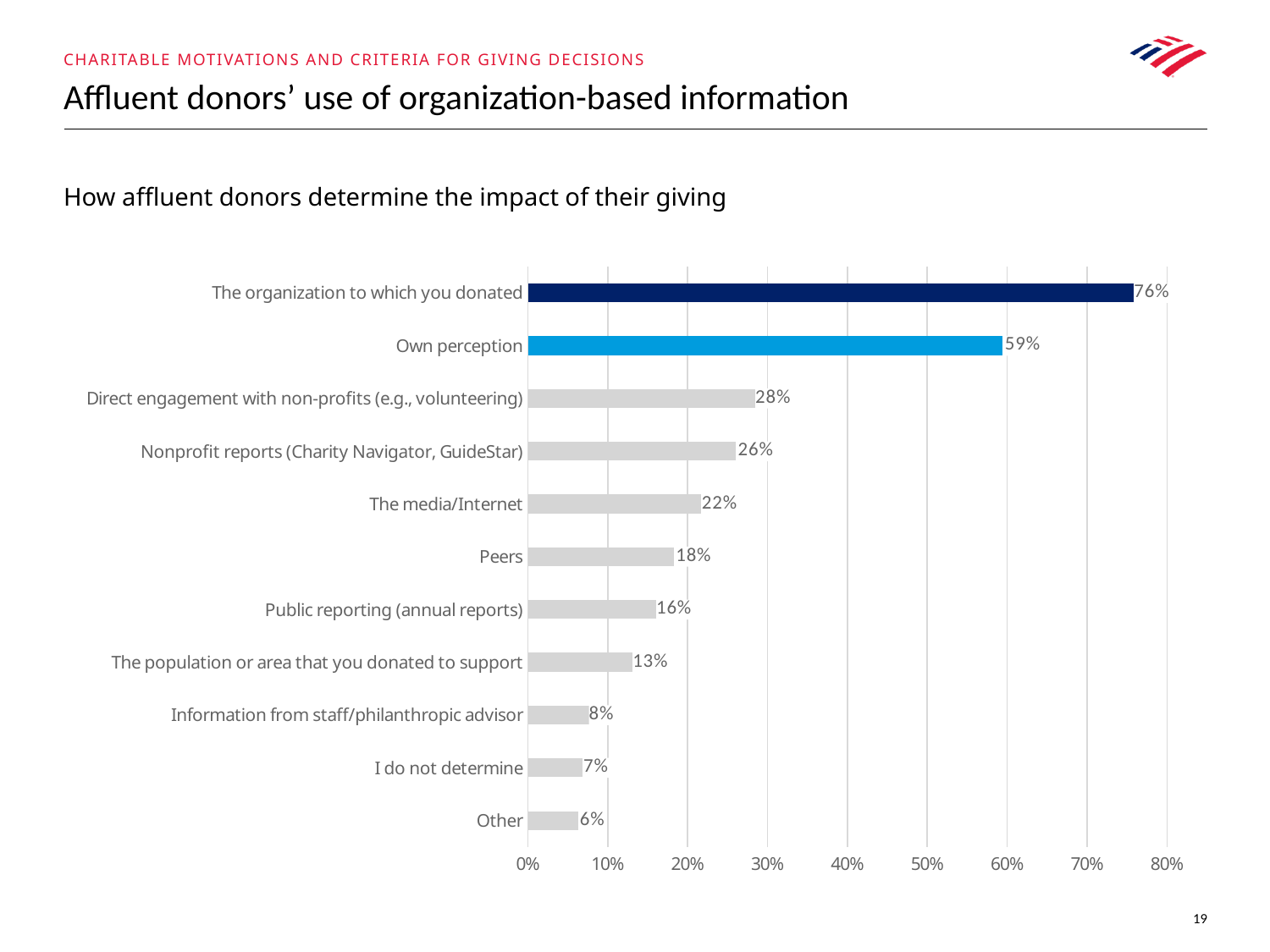
What is the difference between the values for Direct engagement with non-profits (e.g., volunteering) and The media/Internet? 6% Which is larger, the value for Public reporting (annual reports) or the value for The population or area that you donated to support? Public reporting (annual reports) What kind of chart is shown on the slide? Bar chart What is the value for Nonprofit reports (Charity Navigator, GuideStar)? 26% What is the difference between the values for The organization to which you donated and Own perception? 17% What is the value for Peers? 18% Which category has the lowest value? Other What is the title of the chart? How affluent donors determine the impact of their giving Which category has the highest value? The organization to which you donated How many categories are shown in the chart? 11 What is the value for Own perception? 59% What percentage of affluent donors use the organization to which they donated to determine the impact of their giving? 76%